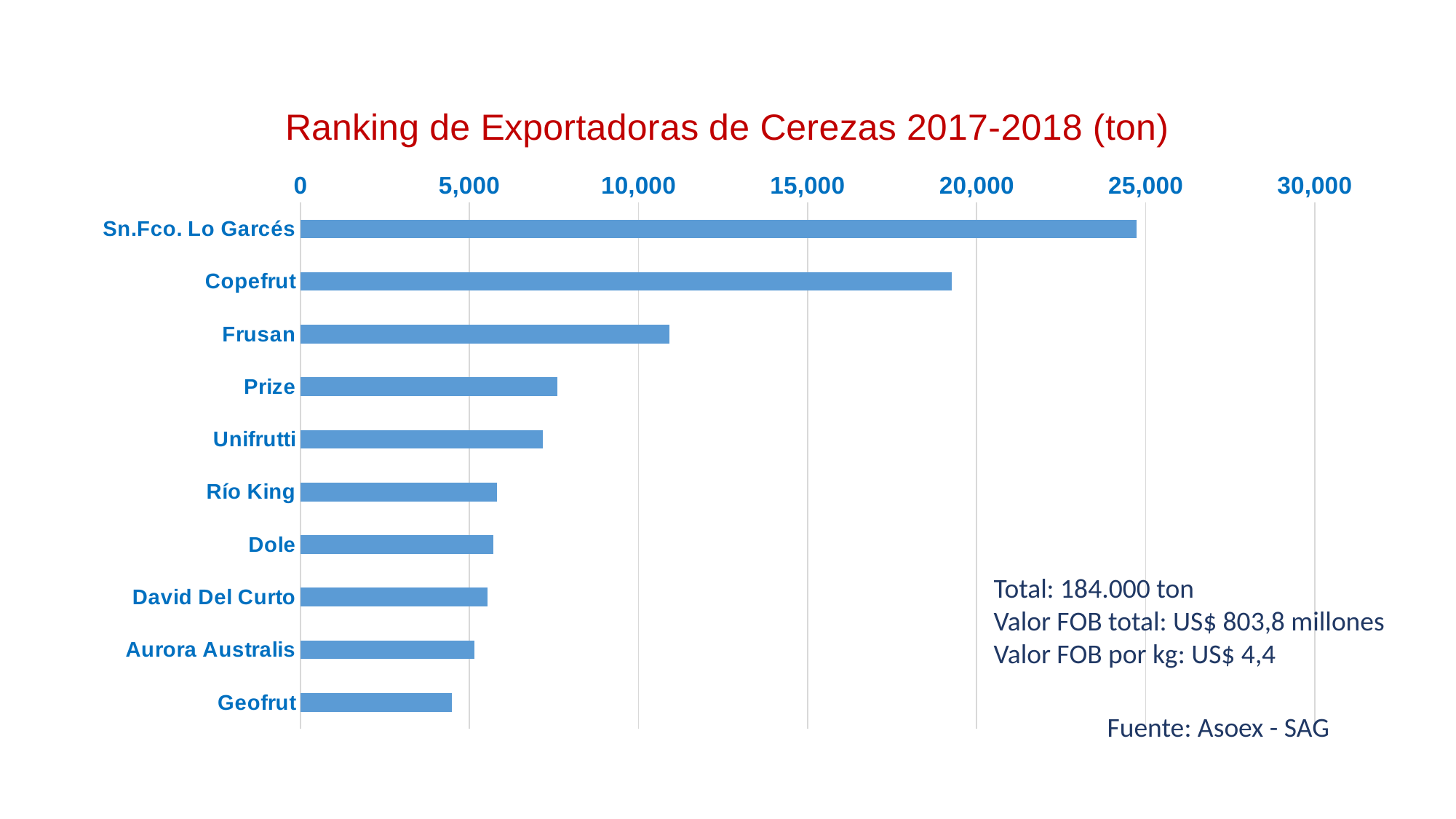
What kind of chart is shown on the slide? Bar chart Which exporter has the highest value in the chart? Sn.Fco. Lo Garcés Is the value for Geofrut greater or less than 5,000? less Which has a larger value, Prize or Unifrutti? Prize Which exporter has the lowest value in the chart? Geofrut Is the value for Copefrut greater or less than 20,000? less Is the value for Sn.Fco. Lo Garcés greater or less than 20,000? greater How many exporters are shown in the chart? 10 Which has a larger value, Copefrut or Frusan? Copefrut What is the title of the chart? Ranking de Exportadoras de Cerezas 2017-2018 (ton)